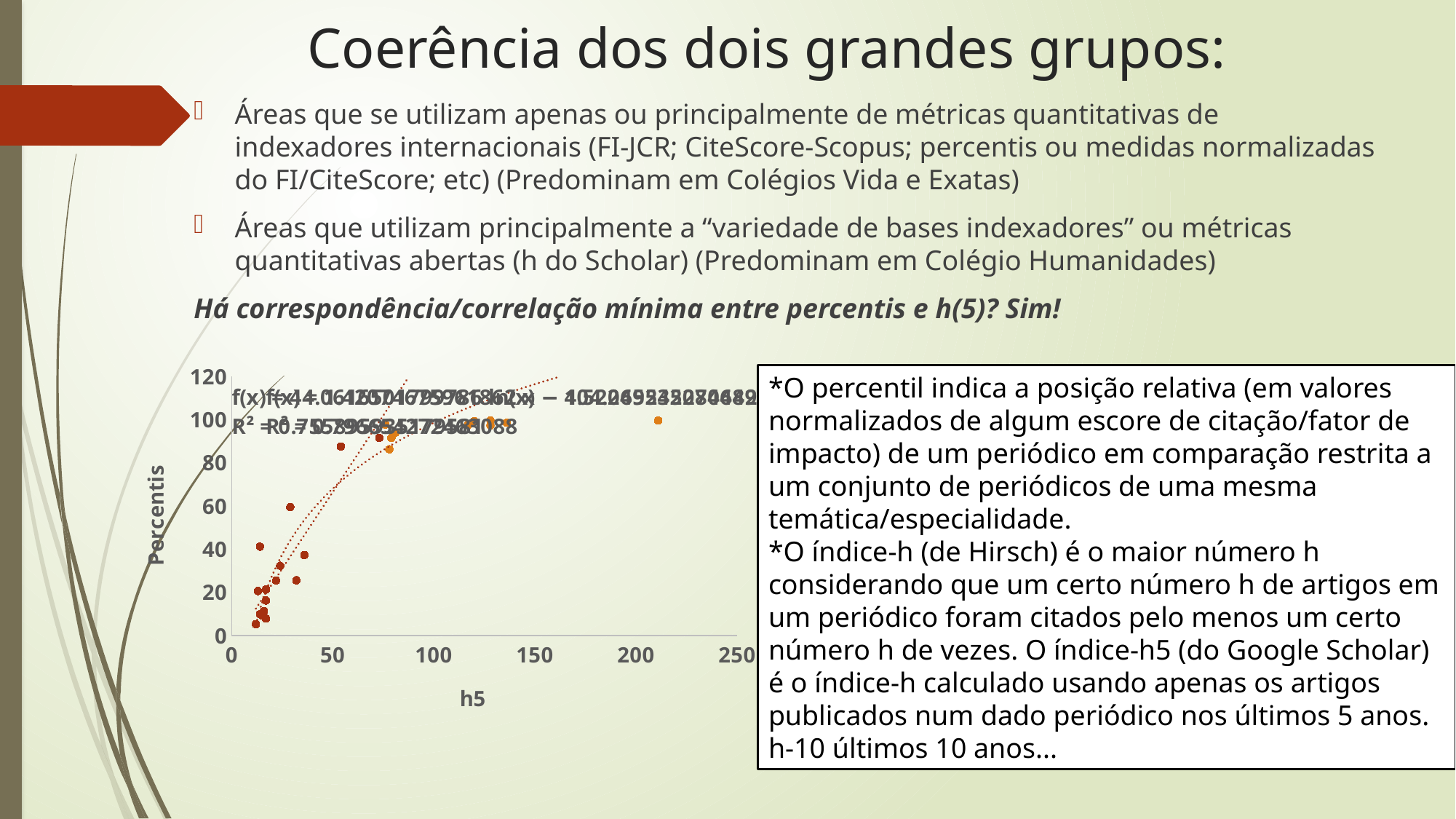
What is the title of the x axis of the chart? h5 Is the h5 value of the rightmost point greater or less than 150? greater Is the Percentis value of the point with the largest h5 greater or less than 80? greater What kind of chart is shown on the slide? scatter chart What is the title of the y axis of the chart? Percentis Is the Percentis value of the lowest point on the chart greater or less than 20? less Do the Percentis values generally rise or fall as h5 increases along the x axis? rise